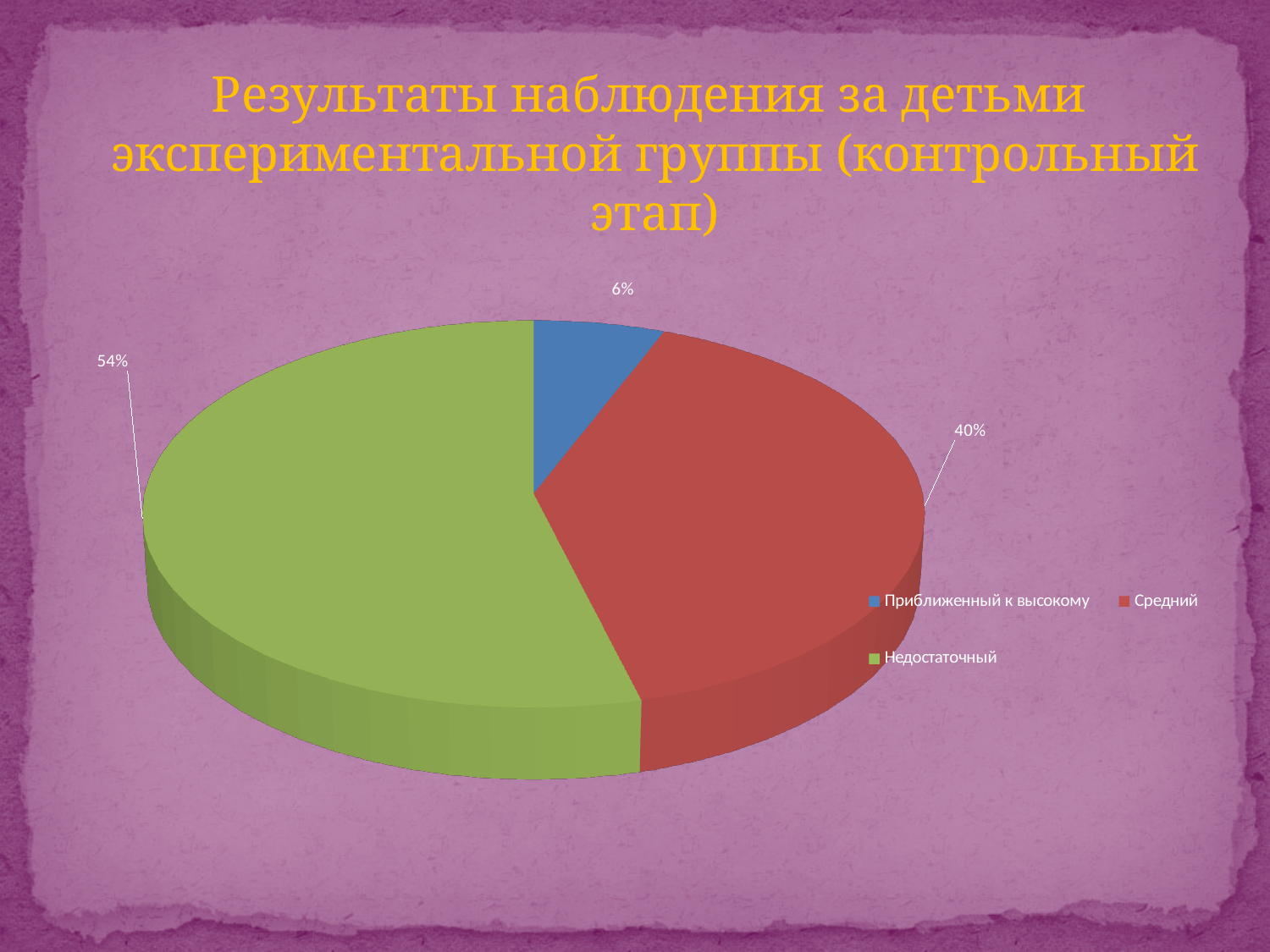
What share of the pie does the "Недостаточный" slice represent? 54% What colour is the "Недостаточный" slice? green Which category has the smallest slice of the pie? Приближенный к высокому What is the title of the chart on the slide? Результаты наблюдения за детьми экспериментальной группы (контрольный этап) Which category has the largest slice of the pie? Недостаточный What share of the pie does the "Средний" slice represent? 40% Which is larger: the "Средний" slice or the "Приближенный к высокому" slice? Средний What is the difference in percentage points between the "Недостаточный" and "Средний" slices? 14 What share of the pie does the "Приближенный к высокому" slice represent? 6% How many categories does the pie chart have? 3 What is the difference in percentage points between the "Средний" and "Приближенный к высокому" slices? 34 What kind of chart is shown on the slide? pie chart